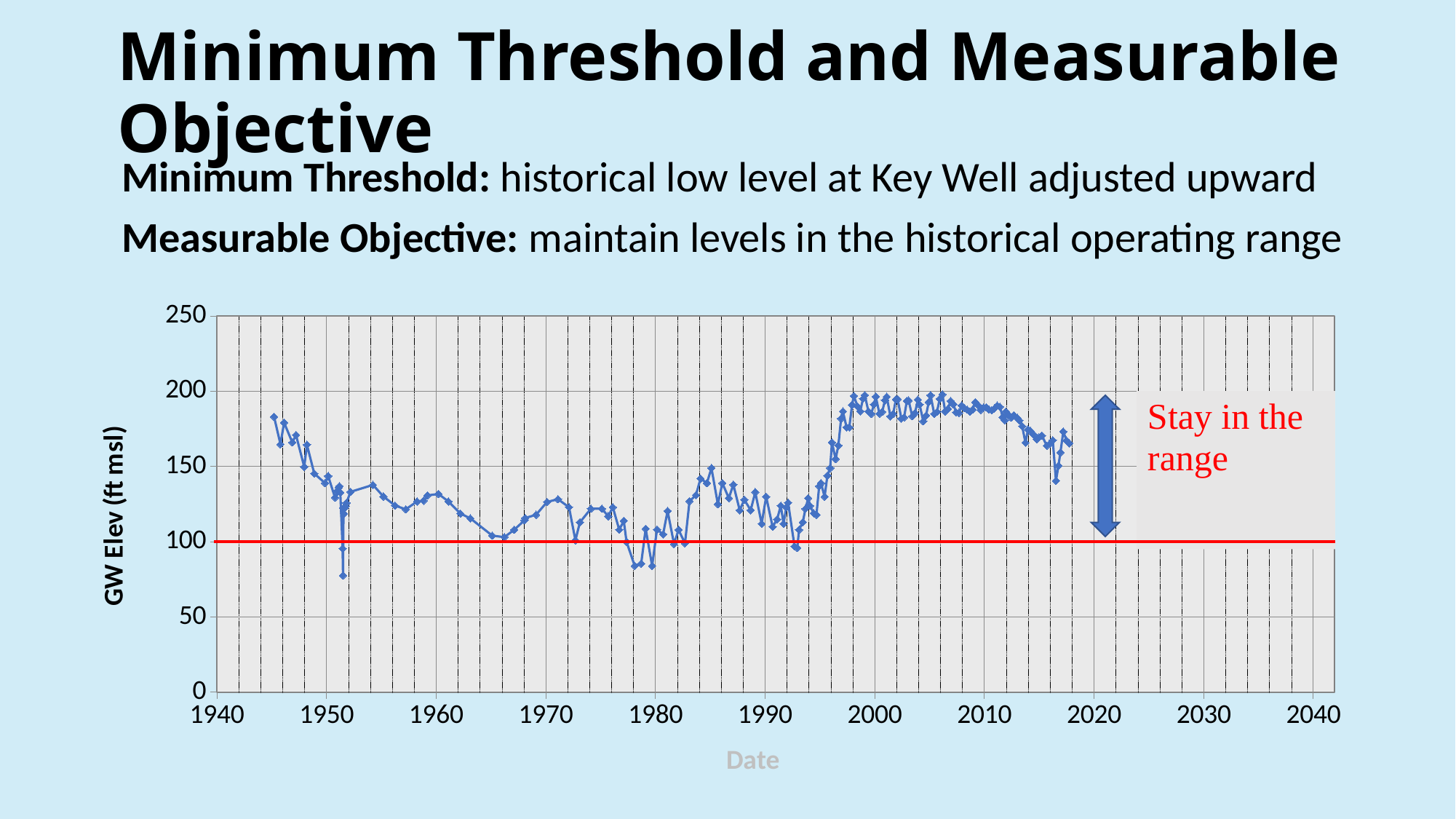
Is the groundwater elevation around 2005 greater or less than 200? less Is the groundwater elevation around 1965 greater or less than 150? less Is the lowest groundwater elevation around 1978 greater or less than 100? less What kind of chart is shown on the slide? line chart What is the label of the vertical axis of the chart? GW Elev (ft msl) Do the groundwater elevation values generally rise or fall between 1945 and 1965? fall At what value on the vertical axis is the red horizontal line drawn? 100 Do the groundwater elevation values generally rise or fall between 2010 and 2017? fall Do the groundwater elevation values generally rise or fall between 1993 and 1998? rise